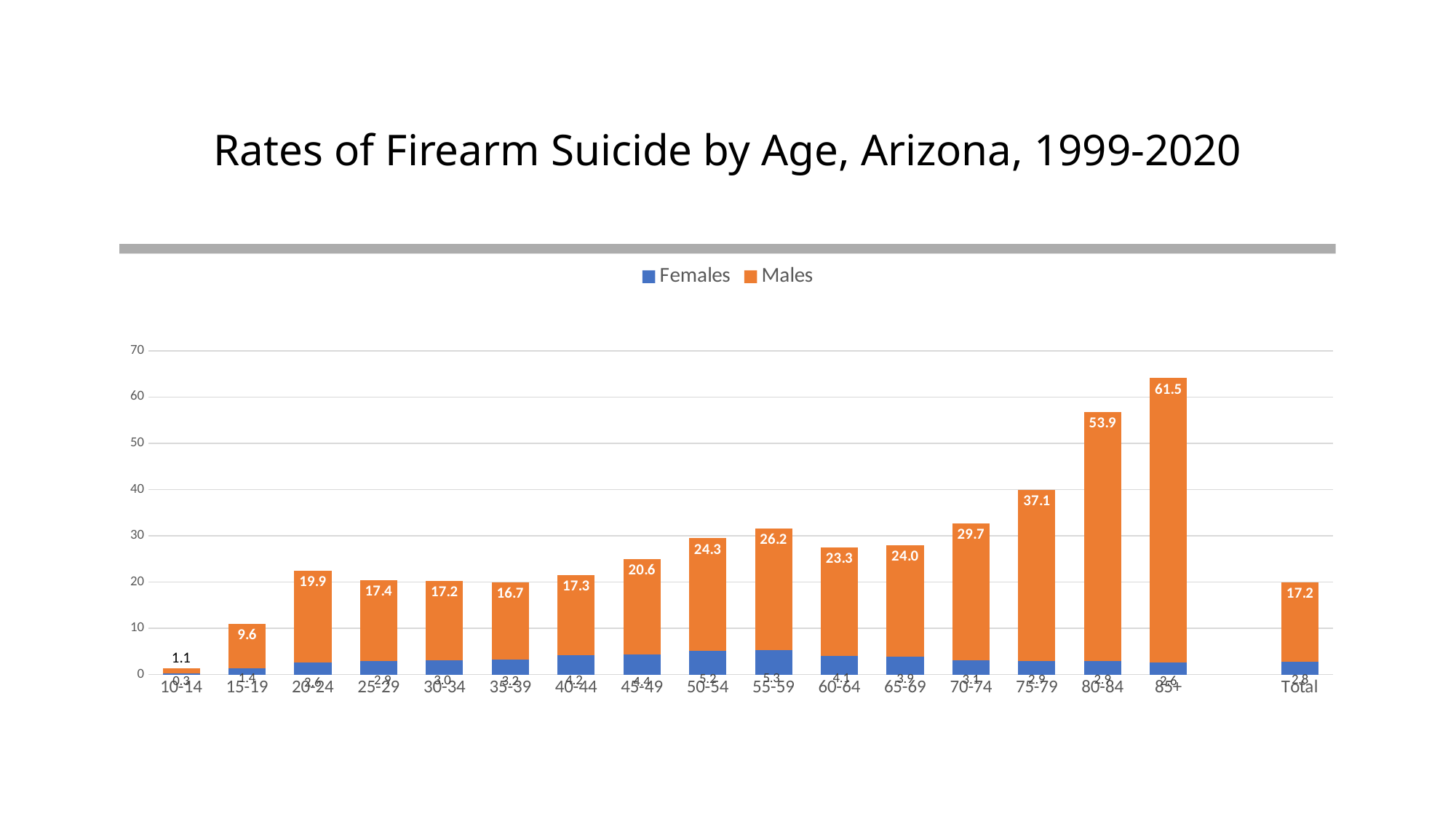
What is the difference between the Males values for the 85+ and 80-84 age groups? 7.6 What is the Males value for the 85+ age group? 61.5 Which age group has the highest Males value? 85+ Which age group has the lowest Males value? 10-14 What is the Males value for the Total bar? 17.2 What kind of chart is shown on the slide? Stacked bar chart Is the Females value for the 50-54 age group greater or less than 10? less What is the Males value for the 15-19 age group? 9.6 What is the title of the chart? Rates of Firearm Suicide by Age, Arizona, 1999-2020 How many age groups (excluding the Total bar) are shown on the x axis? 16 How many series does the legend list? 2 Which age group has a larger Males value, 50-54 or 60-64? 50-54